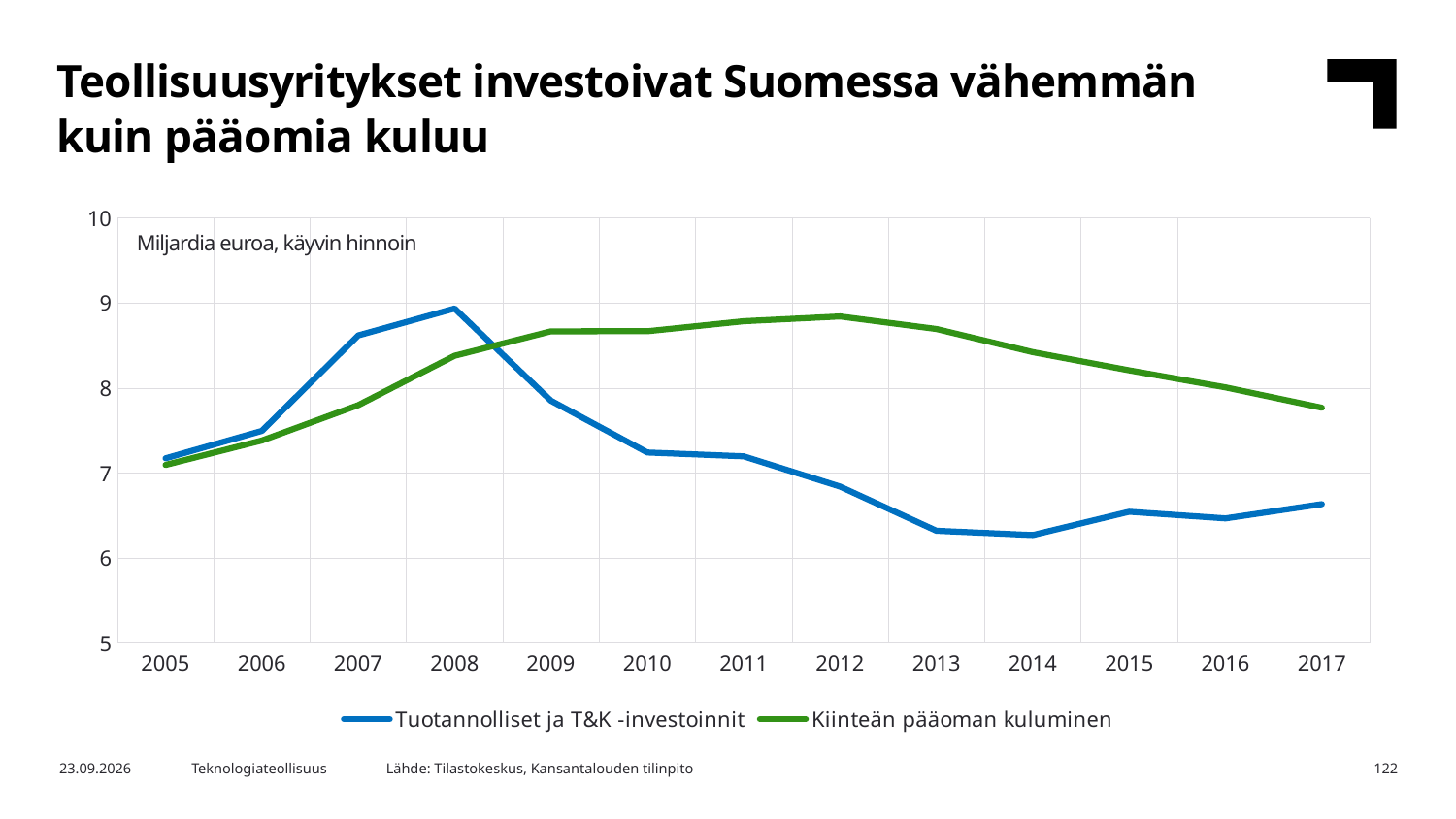
How many series does the legend list? 2 Which series has the larger value in 2017, Tuotannolliset ja T&K -investoinnit or Kiinteän pääoman kuluminen? Kiinteän pääoman kuluminen Is the value for Tuotannolliset ja T&K -investoinnit in 2013 greater or less than 7? less How many years are plotted along the x axis? 13 What unit is stated in the label inside the chart area? Miljardia euroa, käyvin hinnoin Which series has the larger value in 2008, Tuotannolliset ja T&K -investoinnit or Kiinteän pääoman kuluminen? Tuotannolliset ja T&K -investoinnit What kind of chart is shown on the slide? Line chart In which year does the Tuotannolliset ja T&K -investoinnit series reach its highest value? 2008 Is the value for Tuotannolliset ja T&K -investoinnit in 2008 greater or less than 8? greater Does the Kiinteän pääoman kuluminen series rise or fall from 2012 to 2017? Fall In which year is the Kiinteän pääoman kuluminen series at its lowest? 2005 Is the value for Kiinteän pääoman kuluminen in 2017 greater or less than 8? less